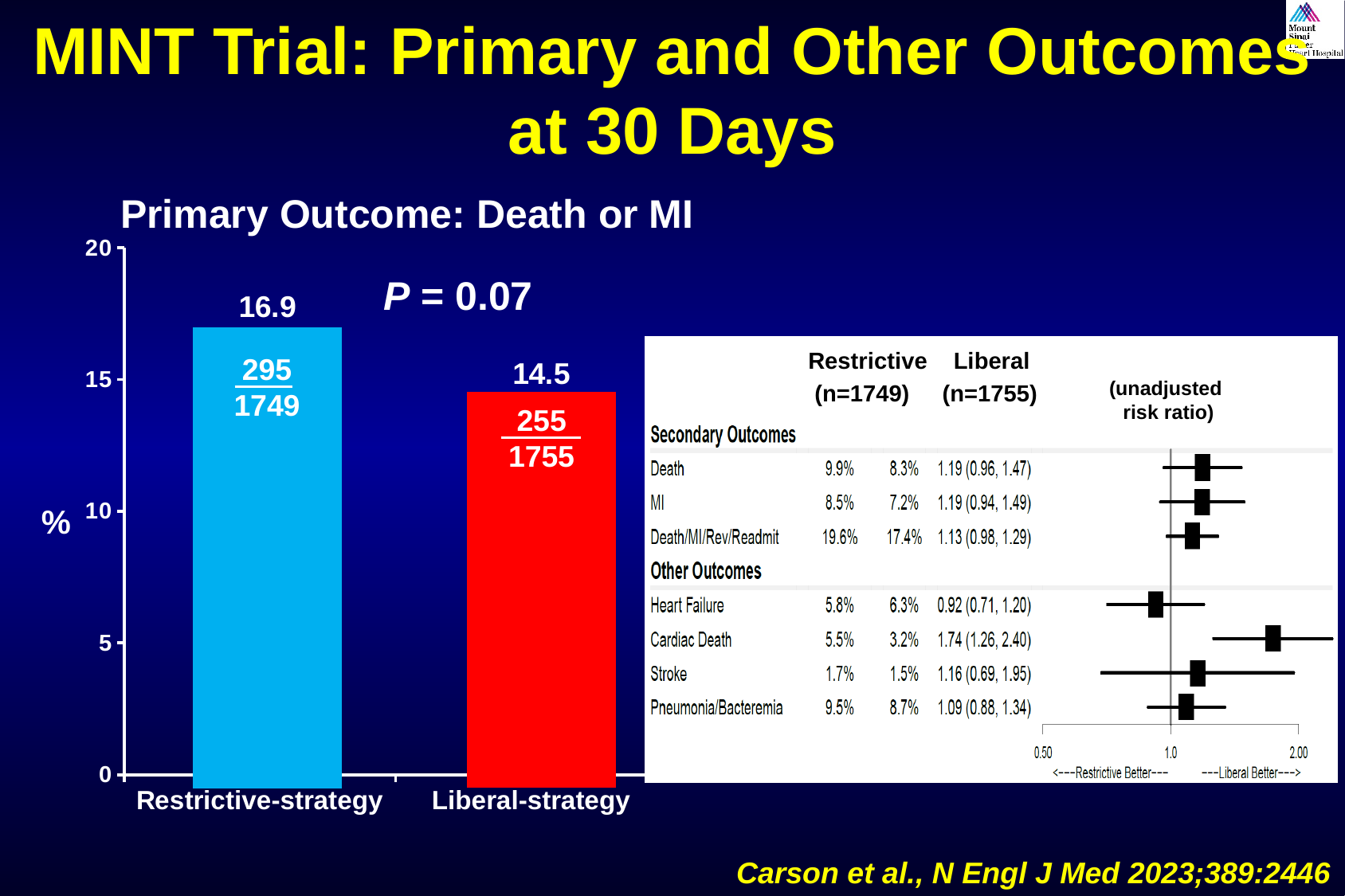
In the bar chart titled "Primary Outcome: Death or MI", is the Liberal-strategy value greater or less than 15? less In the bar chart titled "Primary Outcome: Death or MI", what is the value for the Restrictive-strategy bar? 16.9 In the bar chart titled "Primary Outcome: Death or MI", how many bars are plotted? 2 In the forest plot on the right of the slide, which outcome has the highest unadjusted risk ratio? Cardiac Death In the bar chart titled "Primary Outcome: Death or MI", what is the value for the Liberal-strategy bar? 14.5 In the forest plot on the right of the slide, what is the unadjusted risk ratio for Cardiac Death? 1.74 (1.26, 2.40) In the bar chart titled "Primary Outcome: Death or MI", which strategy has the lower value? Liberal-strategy In the bar chart titled "Primary Outcome: Death or MI", what fraction is printed inside the Restrictive-strategy bar? 295/1749 In the bar chart titled "Primary Outcome: Death or MI", what is the difference between the Restrictive-strategy and Liberal-strategy values? 2.4 In the bar chart titled "Primary Outcome: Death or MI", what P value is shown? P = 0.07 In the bar chart titled "Primary Outcome: Death or MI", which strategy has the higher value? Restrictive-strategy What kind of chart is used for the "Primary Outcome: Death or MI" on the left of the slide? Bar chart